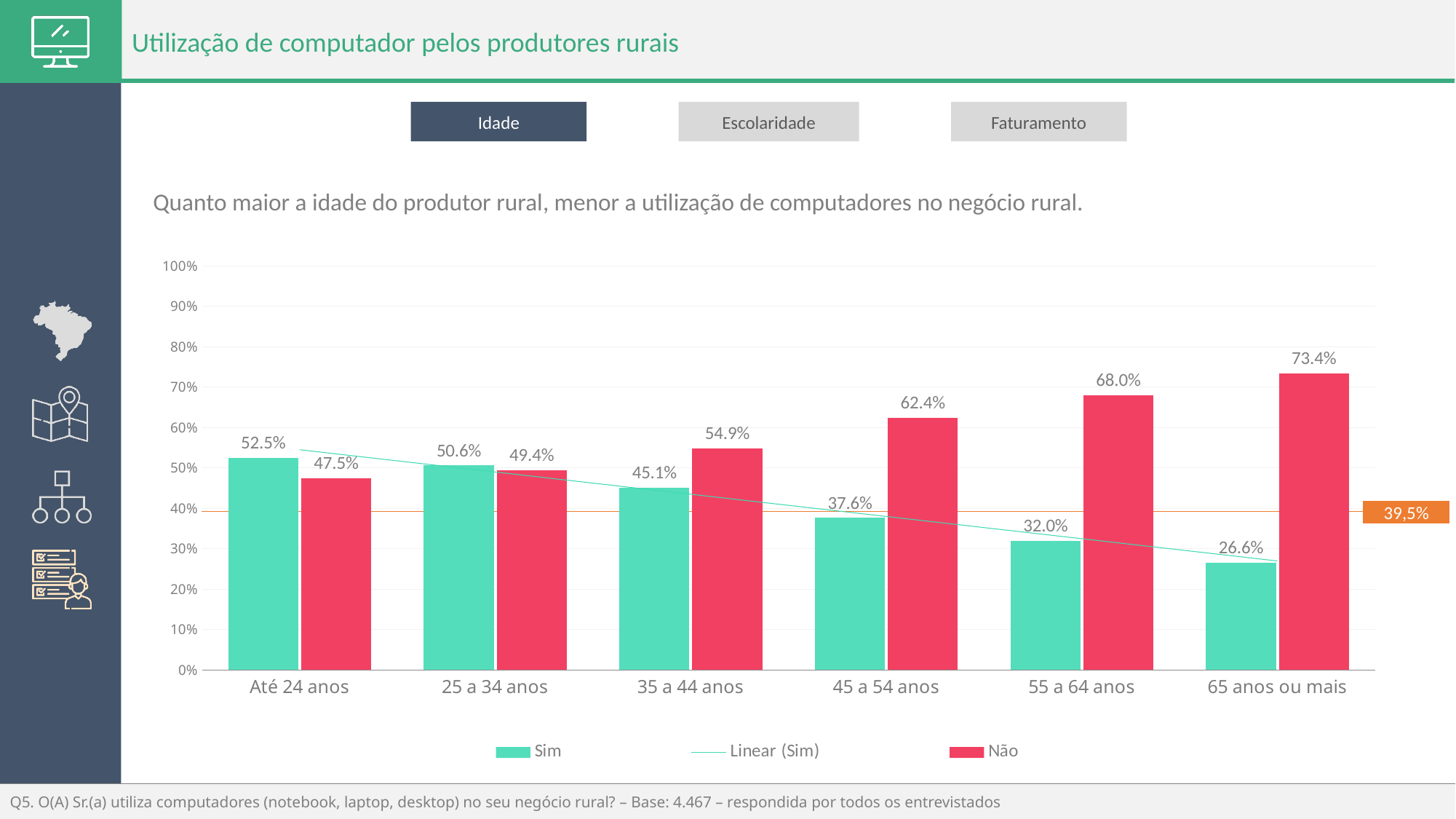
Do the 'Sim' values rise or fall as age increases along the x axis? Fall For the '25 a 34 anos' age group, which is larger, 'Sim' or 'Não'? Sim Which age group has the lowest 'Não' value? Até 24 anos How many entries does the legend list? 3 What is the difference between the 'Não' and 'Sim' values for the '45 a 54 anos' age group? 24.8% Which age group has the highest 'Sim' value? Até 24 anos What value is labelled on the orange horizontal line across the chart? 39,5% What kind of chart is shown on the slide? Bar chart What is the 'Sim' value for the '55 a 64 anos' age group? 32.0% What is the 'Não' value for the '65 anos ou mais' age group? 73.4% How many age groups are shown on the x axis? 6 What is the 'Sim' value for the '35 a 44 anos' age group? 45.1%